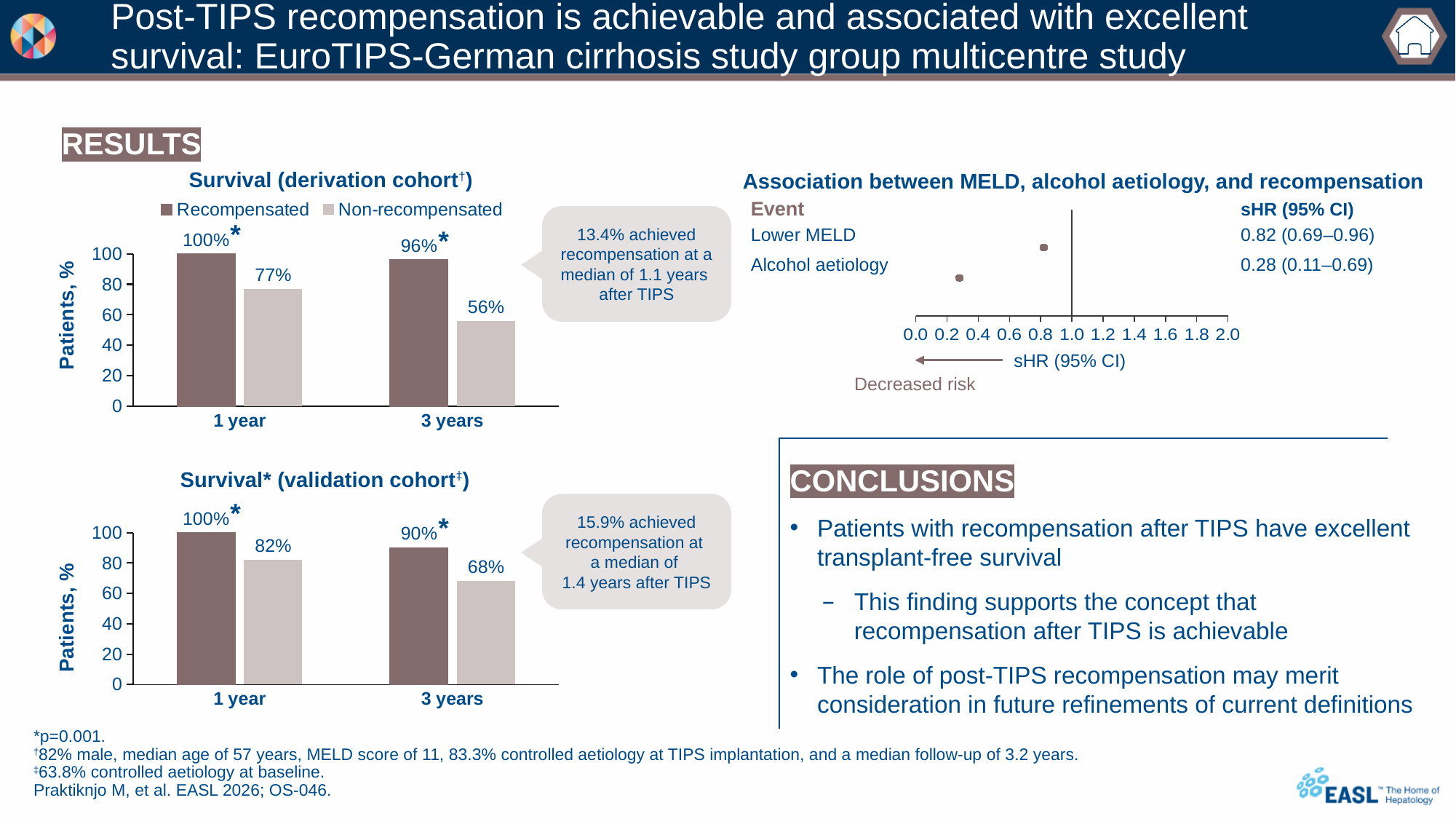
What kind of chart is the 'Survival* (validation cohort)' chart? Bar chart How many series does the legend of the 'Survival (derivation cohort)' chart list? 2 In the 'Survival* (validation cohort)' chart, which is larger at 1 year: Recompensated or Non-recompensated? Recompensated In the 'Survival* (validation cohort)' chart, what is the value for Recompensated patients at 3 years? 90% In the 'Survival* (validation cohort)' chart, what is the value for Non-recompensated patients at 1 year? 82% In the 'Survival (derivation cohort)' chart, what is the value for Non-recompensated patients at 3 years? 56% In the 'Survival* (validation cohort)' chart, what is the difference between Recompensated and Non-recompensated survival at 3 years? 22 percentage points In the 'Association between MELD, alcohol aetiology, and recompensation' chart, what is the sHR (95% CI) for Lower MELD? 0.82 (0.69–0.96) In the 'Survival (derivation cohort)' chart, what is the difference between Recompensated and Non-recompensated survival at 3 years? 40 percentage points In the 'Association between MELD, alcohol aetiology, and recompensation' chart, what is the sHR (95% CI) for Alcohol aetiology? 0.28 (0.11–0.69) In the 'Survival (derivation cohort)' chart, what is the value for Recompensated patients at 1 year? 100% In the 'Survival (derivation cohort)' chart, does Non-recompensated survival rise or fall from 1 year to 3 years? Fall